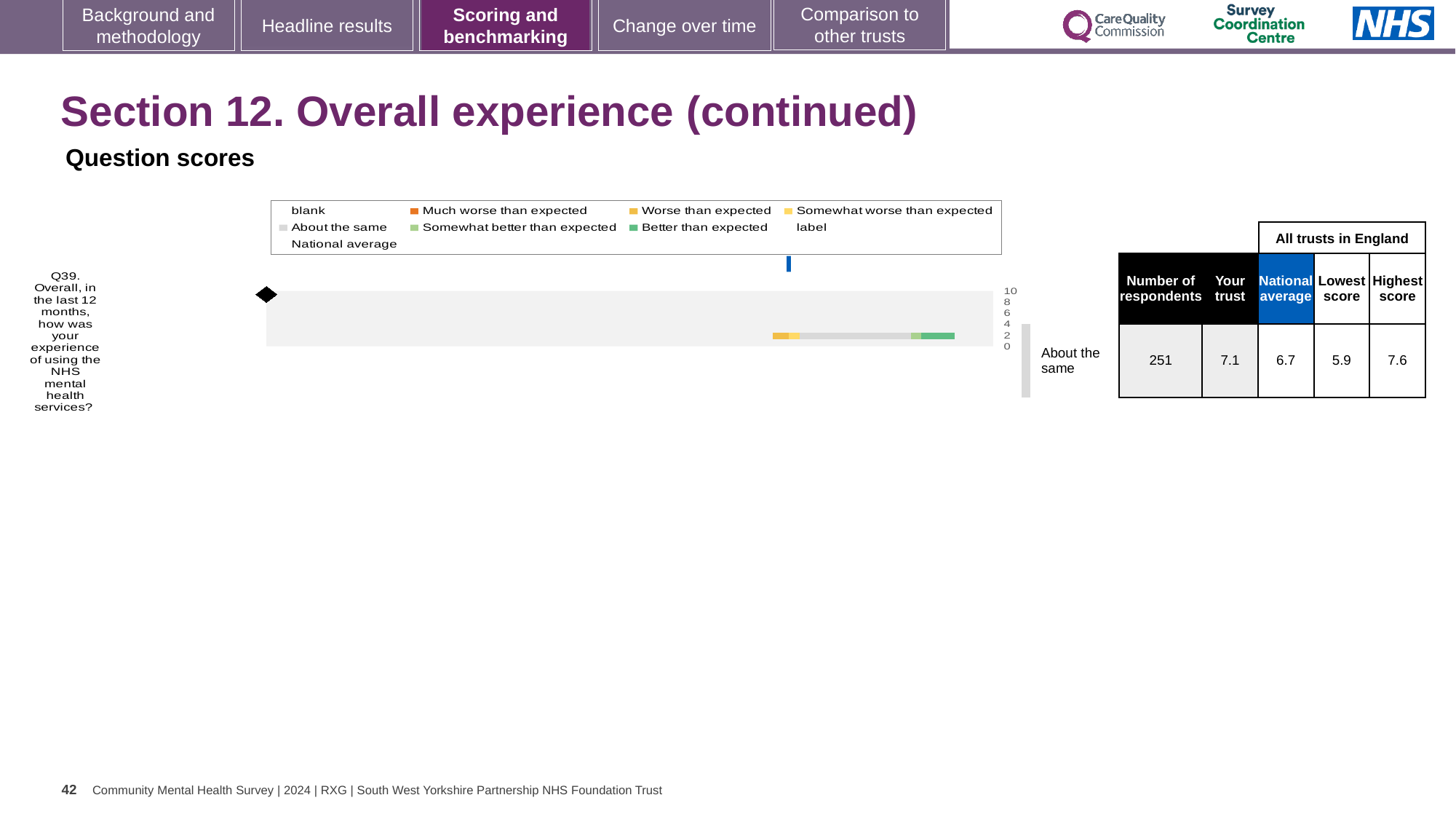
What is the highest score among all trusts in England for Q39? 7.6 What kind of chart is used to show the Q39 benchmarking result? Bar chart How many questions are plotted on the chart? 1 What is the difference between the highest and lowest scores among all trusts in England for Q39? 1.7 How many respondents answered Q39? 251 What is the 'Your trust' score for Q39 shown in the table next to the chart? 7.1 What is the national average score for Q39 shown in the table? 6.7 What is the difference between the trust's score and the national average for Q39? 0.4 Which legend entry is shown with a dark green colour? Better than expected What is the lowest score among all trusts in England for Q39? 5.9 Which is larger for Q39: the trust's score or the national average? Your trust What benchmarking category is the trust's result for Q39 labelled as? About the same